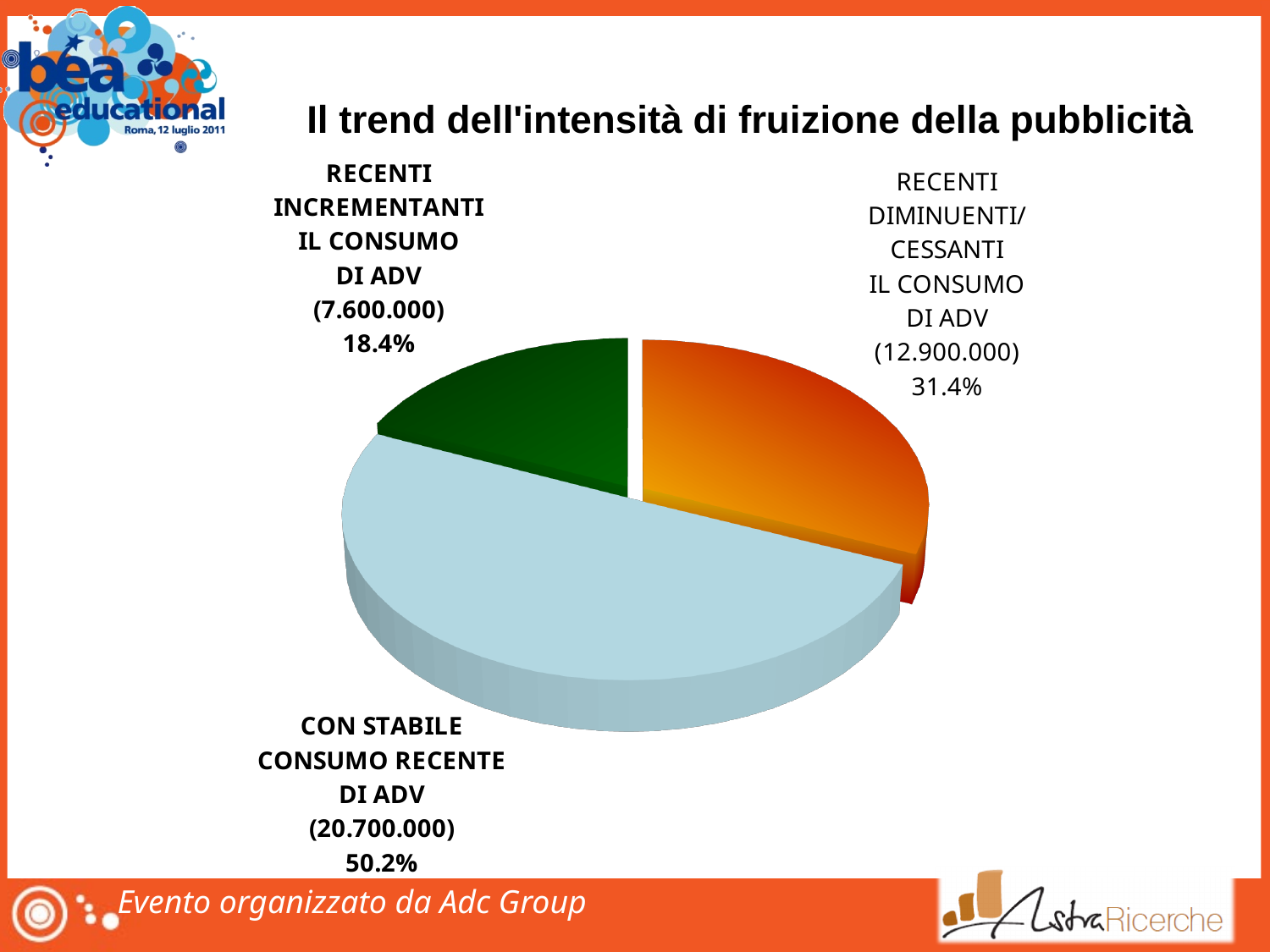
What percentage share is shown for 'RECENTI DIMINUENTI/CESSANTI IL CONSUMO DI ADV'? 31.4% Which slice of the pie chart is the largest? CON STABILE CONSUMO RECENTE DI ADV What is the difference in percentage points between the 'RECENTI DIMINUENTI/CESSANTI' slice and the 'RECENTI INCREMENTANTI' slice? 13.0% What number of people is shown in parentheses for 'RECENTI INCREMENTANTI IL CONSUMO DI ADV'? 7.600.000 Which slice of the pie chart is the smallest? RECENTI INCREMENTANTI IL CONSUMO DI ADV What number of people is shown in parentheses for 'RECENTI DIMINUENTI/CESSANTI IL CONSUMO DI ADV'? 12.900.000 What number of people is shown in parentheses for 'CON STABILE CONSUMO RECENTE DI ADV'? 20.700.000 What percentage share is shown for 'RECENTI INCREMENTANTI IL CONSUMO DI ADV'? 18.4% What percentage share is shown for 'CON STABILE CONSUMO RECENTE DI ADV'? 50.2% What is the title of the chart on the slide? Il trend dell'intensità di fruizione della pubblicità What kind of chart is shown on the slide? pie chart How many slices does the pie chart have? 3